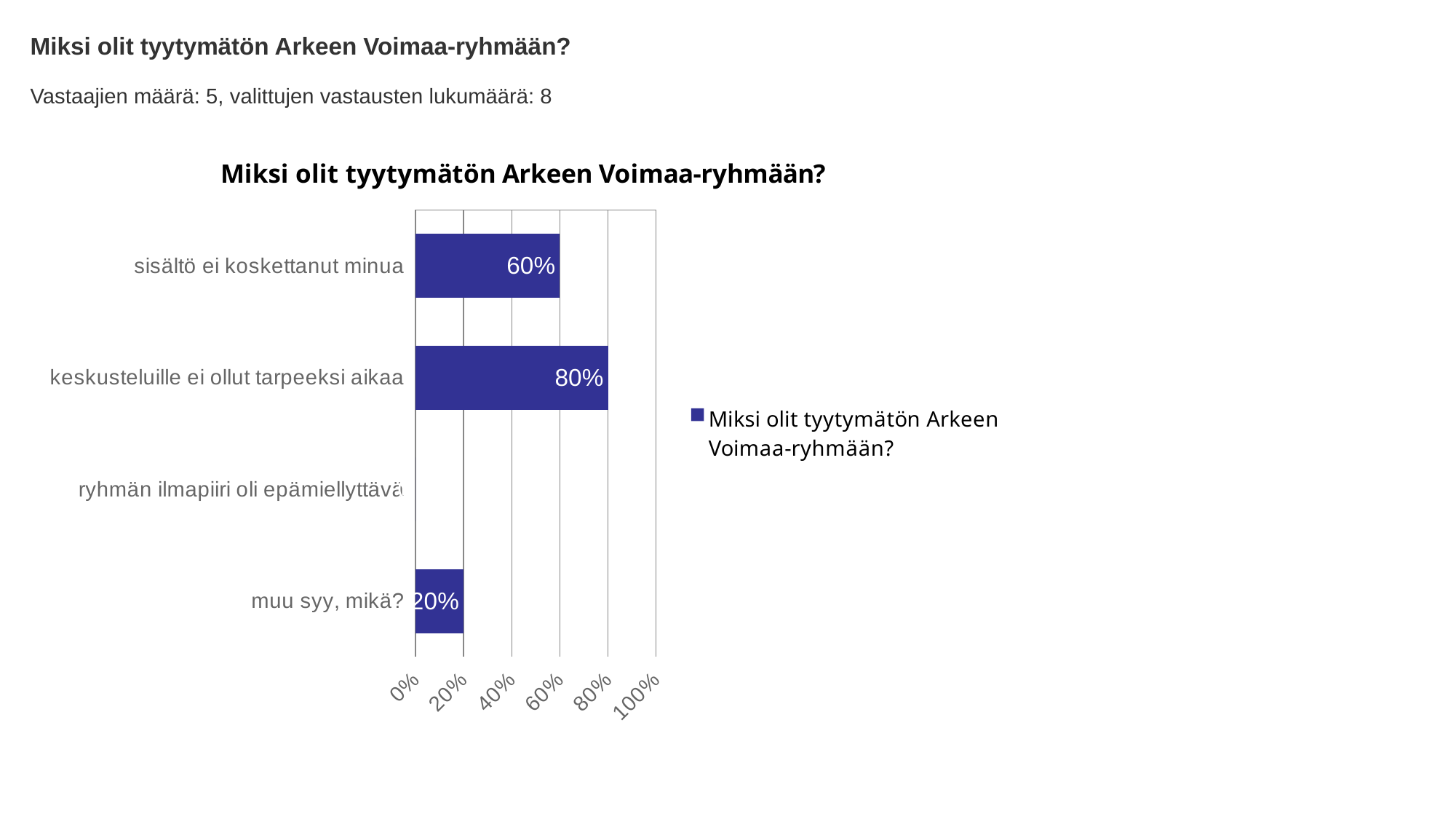
Which is larger, the value for "sisältö ei koskettanut minua" or the value for "muu syy, mikä?"? sisältö ei koskettanut minua Is the value for "keskusteluille ei ollut tarpeeksi aikaa" greater or less than 40%? greater What is the difference between the values for "keskusteluille ei ollut tarpeeksi aikaa" and "sisältö ei koskettanut minua"? 20% Which category has the highest value? keskusteluille ei ollut tarpeeksi aikaa What is the value for "sisältö ei koskettanut minua"? 60% What is the value for "muu syy, mikä?"? 20% How many series does the legend list? 1 How many categories are shown on the chart? 4 What is the title of the chart? Miksi olit tyytymätön Arkeen Voimaa-ryhmään? What kind of chart is shown on the slide? bar chart Which category with a visible bar has the lowest value? muu syy, mikä? What is the value for "keskusteluille ei ollut tarpeeksi aikaa"? 80%